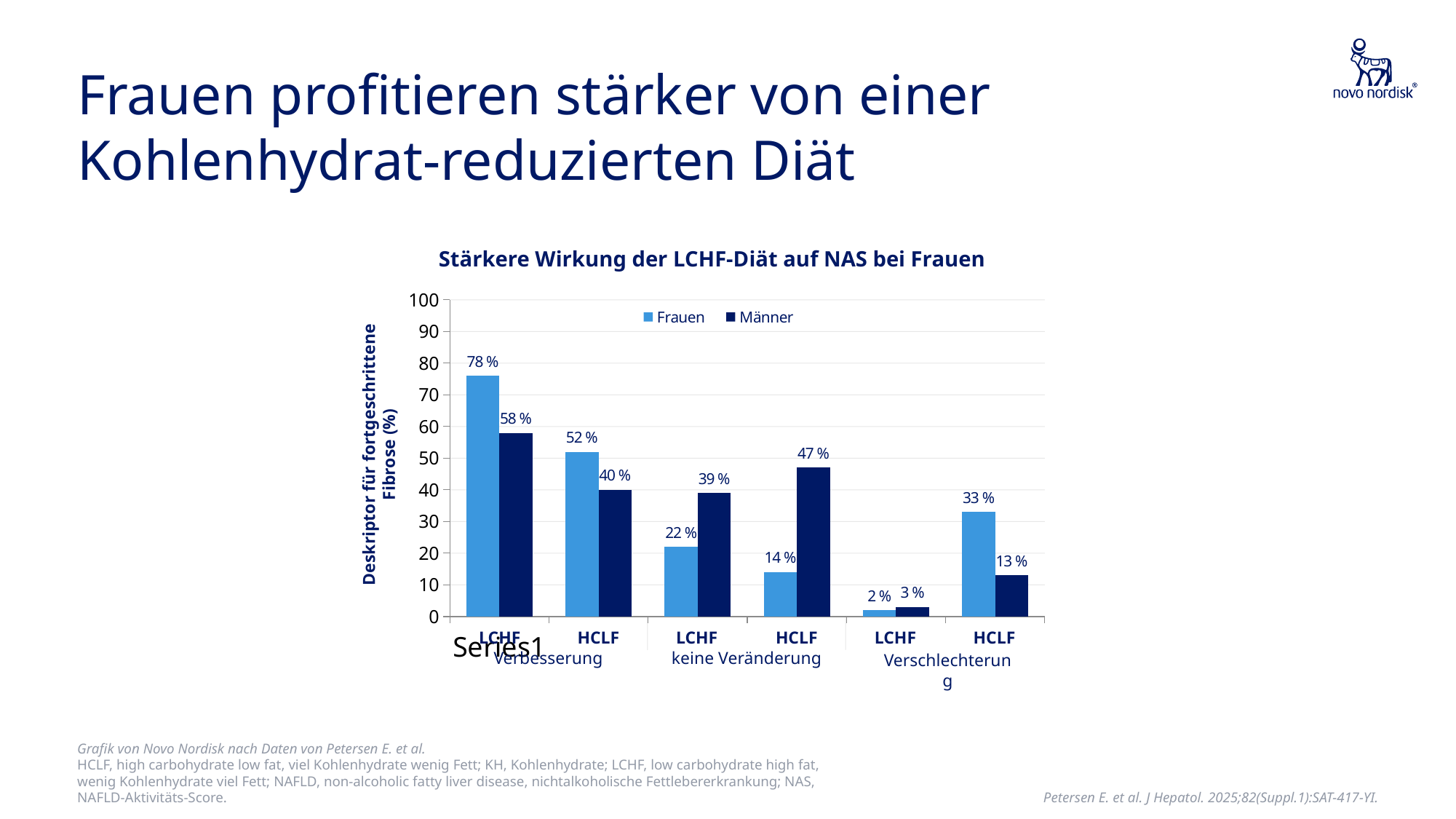
What kind of chart is shown on the slide? Bar chart Which category has the lowest value for Männer? LCHF Verschlechterung What is the value for Frauen in the HCLF Verschlechterung category? 33 % What is the value for Frauen in the LCHF Verbesserung category? 78 % What is the difference between the Frauen and Männer values in the LCHF Verbesserung category? 20 % What is the label of the y axis? Deskriptor für fortgeschrittene Fibrose (%) How many series does the legend list? 2 What is the value for Männer in the HCLF keine Veränderung category? 47 % What is the title of the chart? Stärkere Wirkung der LCHF-Diät auf NAS bei Frauen Which category has the highest value for Frauen? LCHF Verbesserung What is the value for Männer in the LCHF Verschlechterung category? 3 % In the HCLF keine Veränderung category, which is larger, the Frauen value or the Männer value? Männer